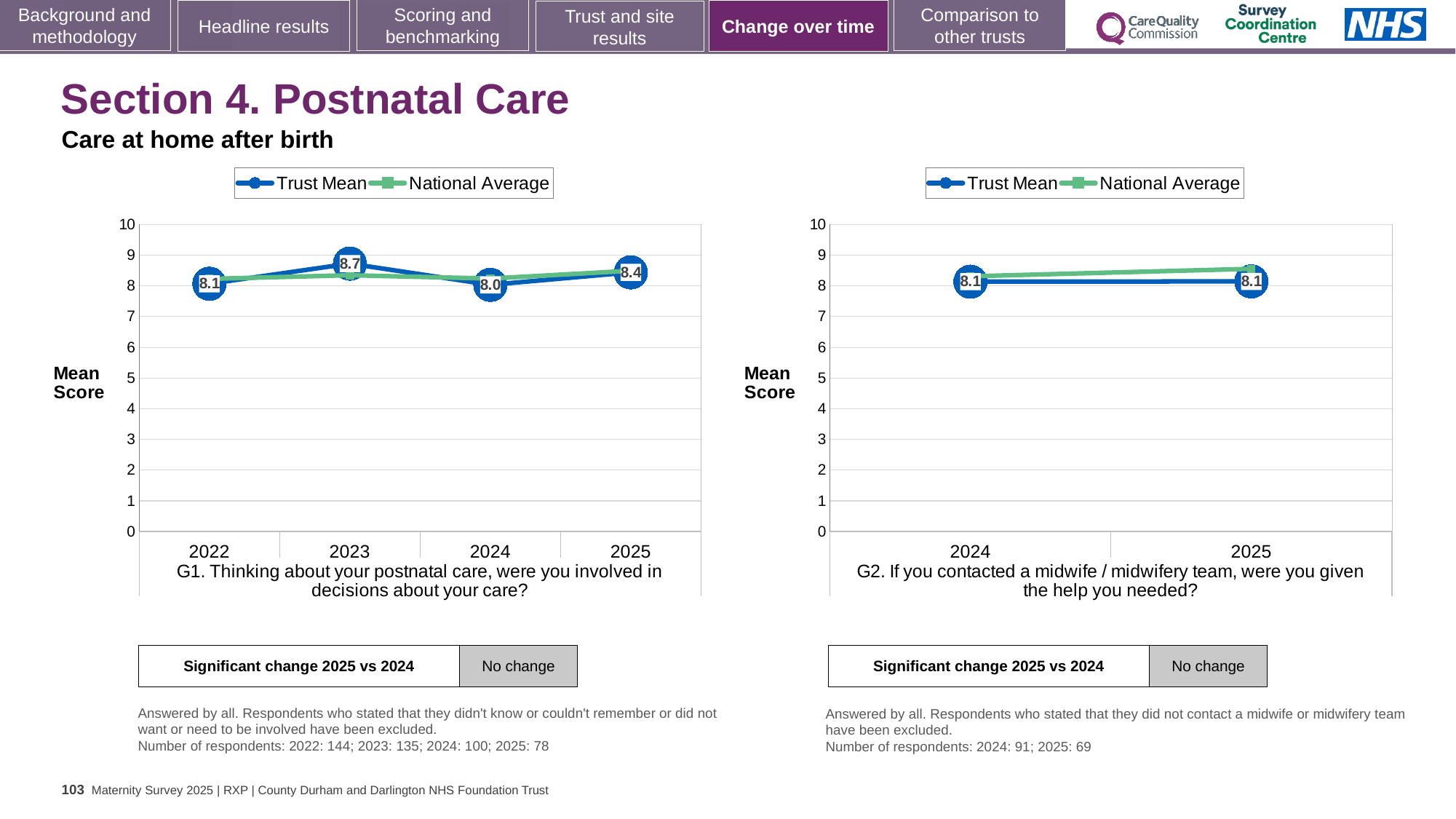
What kind of chart is the G2 chart on the right? Line chart How many series does the legend of the G1 chart on the left list? 2 In the G1 chart on the left, which year has the highest Trust Mean score? 2023 In the G1 chart on the left, how many years are plotted on the x axis? 4 In the G1 chart on the left, what is the difference between the Trust Mean scores for 2023 and 2024? 0.7 In the G2 chart on the right, what is the Trust Mean score for 2024? 8.1 In the G1 chart on the left, is the Trust Mean score for 2022 or 2025 larger? 2025 In the G2 chart on the right, how many years are plotted on the x axis? 2 In the G1 chart on the left, what is the Trust Mean score for 2025? 8.4 In the G1 chart on the left, what is the Trust Mean score for 2023? 8.7 In the G1 chart on the left, which year has the lowest Trust Mean score? 2024 In the G2 chart on the right, is the National Average for 2025 greater or less than 8? greater